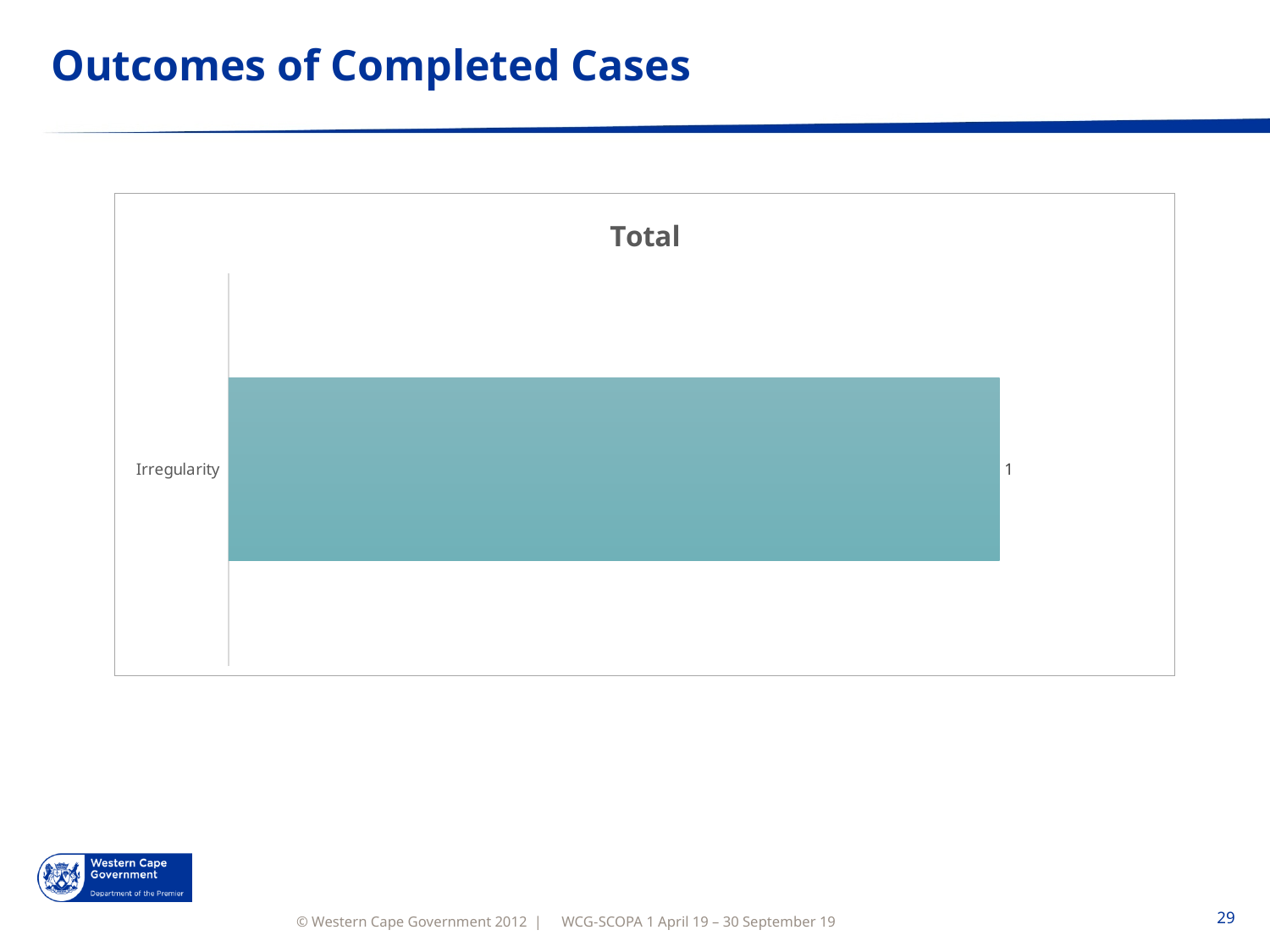
Which category has the highest value in the chart? Irregularity What is the title of the chart? Total What is the value for Irregularity? 1 What kind of chart is shown on the slide? bar chart How many categories does the chart show? 1 Which category is shown on the chart? Irregularity